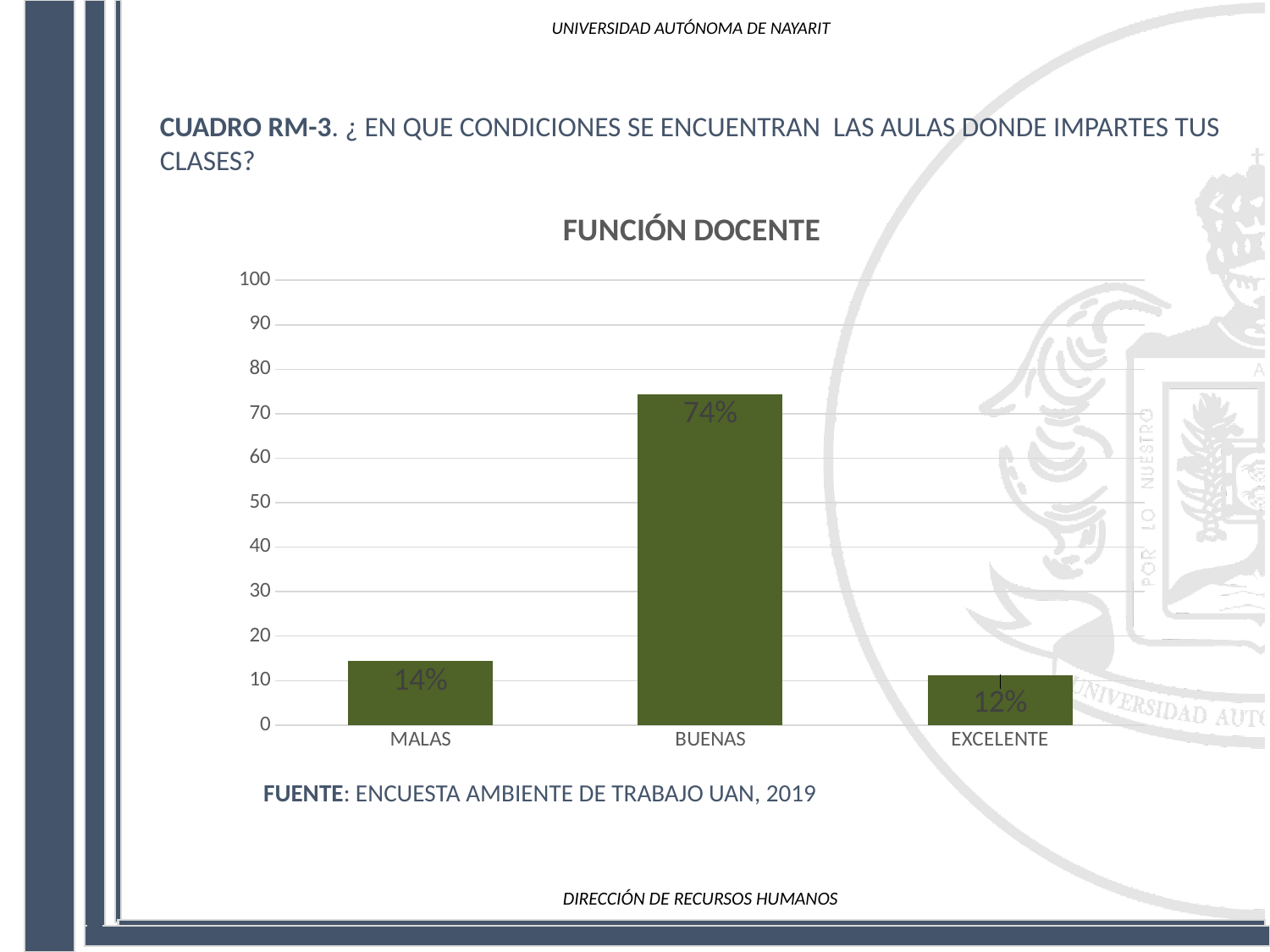
Which is larger, the value for BUENAS or the value for EXCELENTE? BUENAS Is the value for BUENAS greater or less than 50? greater What is the title of the chart? FUNCIÓN DOCENTE What is the difference between the values for BUENAS and MALAS? 60% What is the difference between the values for MALAS and EXCELENTE? 2% What is the value for MALAS? 14% What is the value for EXCELENTE? 12% How many categories are shown on the x axis? 3 What kind of chart is shown on the slide? bar chart Is the value for MALAS greater or less than 20? less Which category has the highest value? BUENAS What is the value for BUENAS? 74%